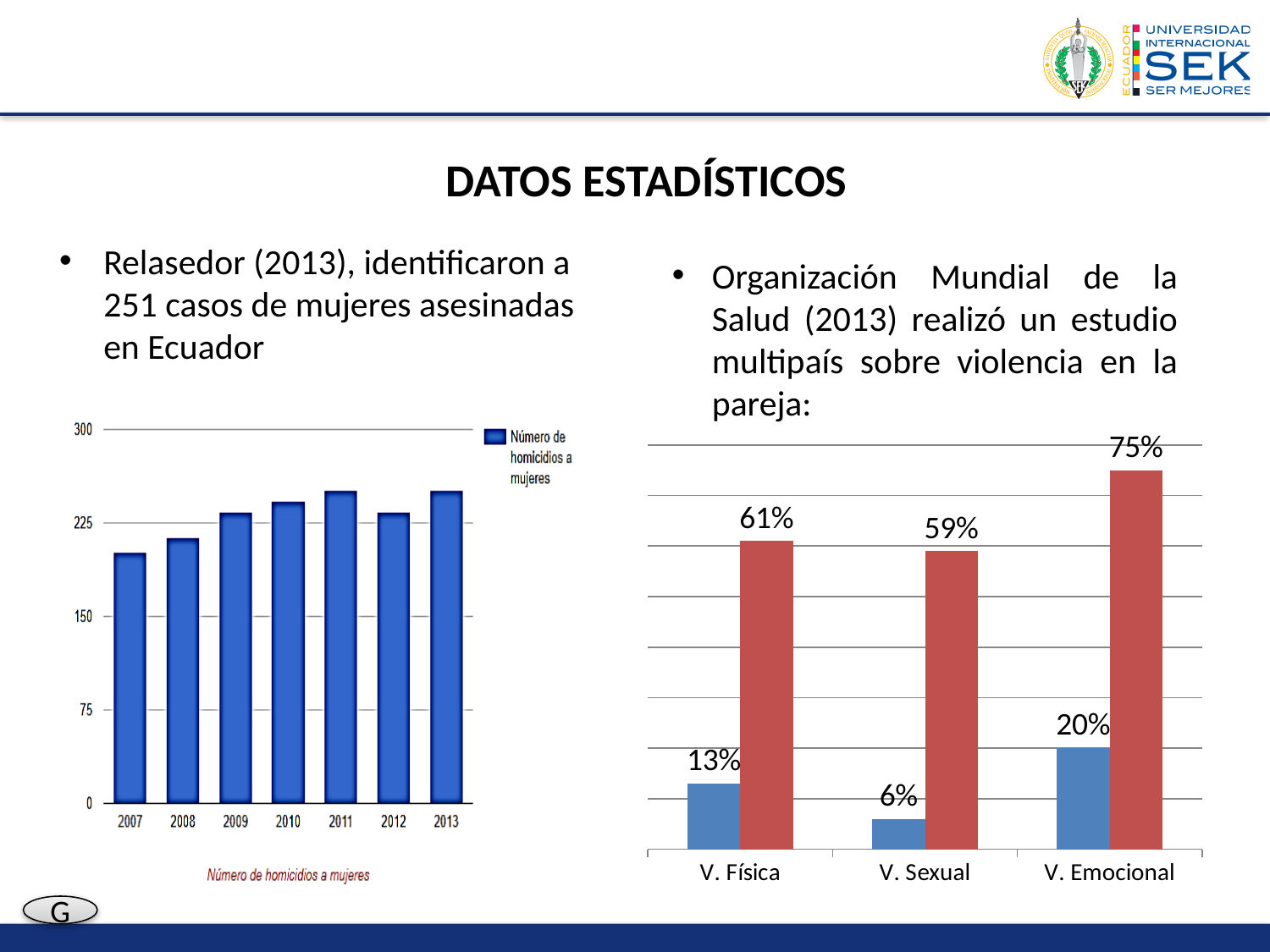
In the left chart (Número de homicidios a mujeres), is the value for 2008 greater or less than 150? greater In the right chart, what is the difference between the red bar for V. Emocional and the red bar for V. Física? 14 percentage points In the right chart, what is the value of the blue bar for V. Sexual? 6% What type of chart is the left chart (Número de homicidios a mujeres)? bar chart In the right chart, what is the value of the red bar for V. Emocional? 75% How many years are shown on the x axis of the left chart (Número de homicidios a mujeres)? 7 In the left chart (Número de homicidios a mujeres), is the value for 2011 greater or less than 225? greater How many categories are shown on the x axis of the right chart? 3 What is the legend entry of the left chart? Número de homicidios a mujeres In the left chart (Número de homicidios a mujeres), which year has the lowest number of homicides? 2007 In the right chart, which category has the highest red bar? V. Emocional In the left chart (Número de homicidios a mujeres), is the value for 2007 greater or less than 225? less